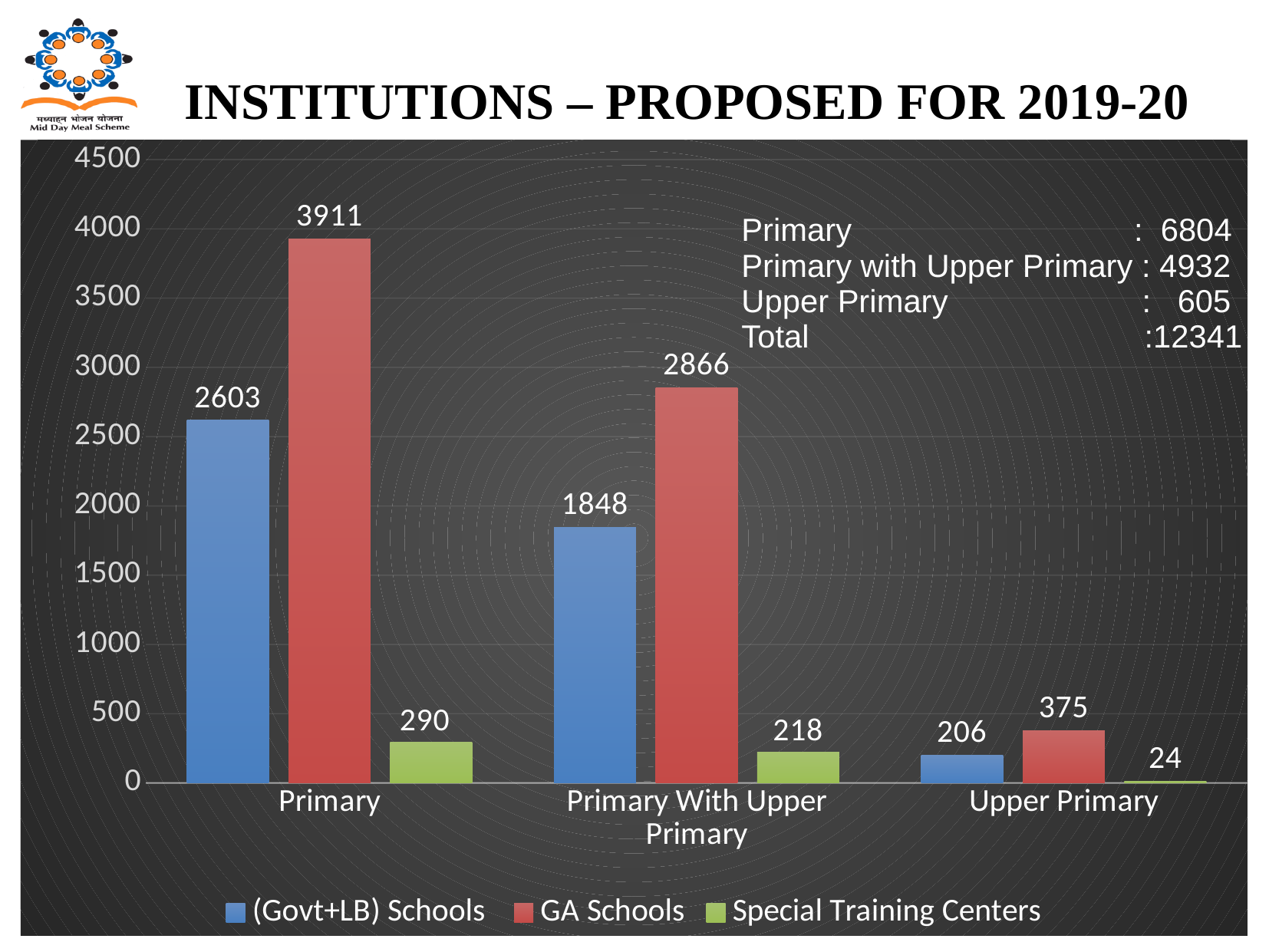
What is the value for Special Training Centers in the Upper Primary category? 24 Which is larger in the Upper Primary category: (Govt+LB) Schools or GA Schools? GA Schools Which category has the highest value for GA Schools? Primary How many series does the legend list? 3 What is the value for GA Schools in the Primary category? 3911 Is the value for GA Schools in the Primary With Upper Primary category greater or less than 3000? less How many categories are shown on the x axis? 3 What kind of chart is shown on the slide? bar chart Which category has the lowest value for (Govt+LB) Schools? Upper Primary Which colour represents Special Training Centers in the legend? green What is the difference between GA Schools and (Govt+LB) Schools in the Primary category? 1308 What is the value for (Govt+LB) Schools in the Primary With Upper Primary category? 1848